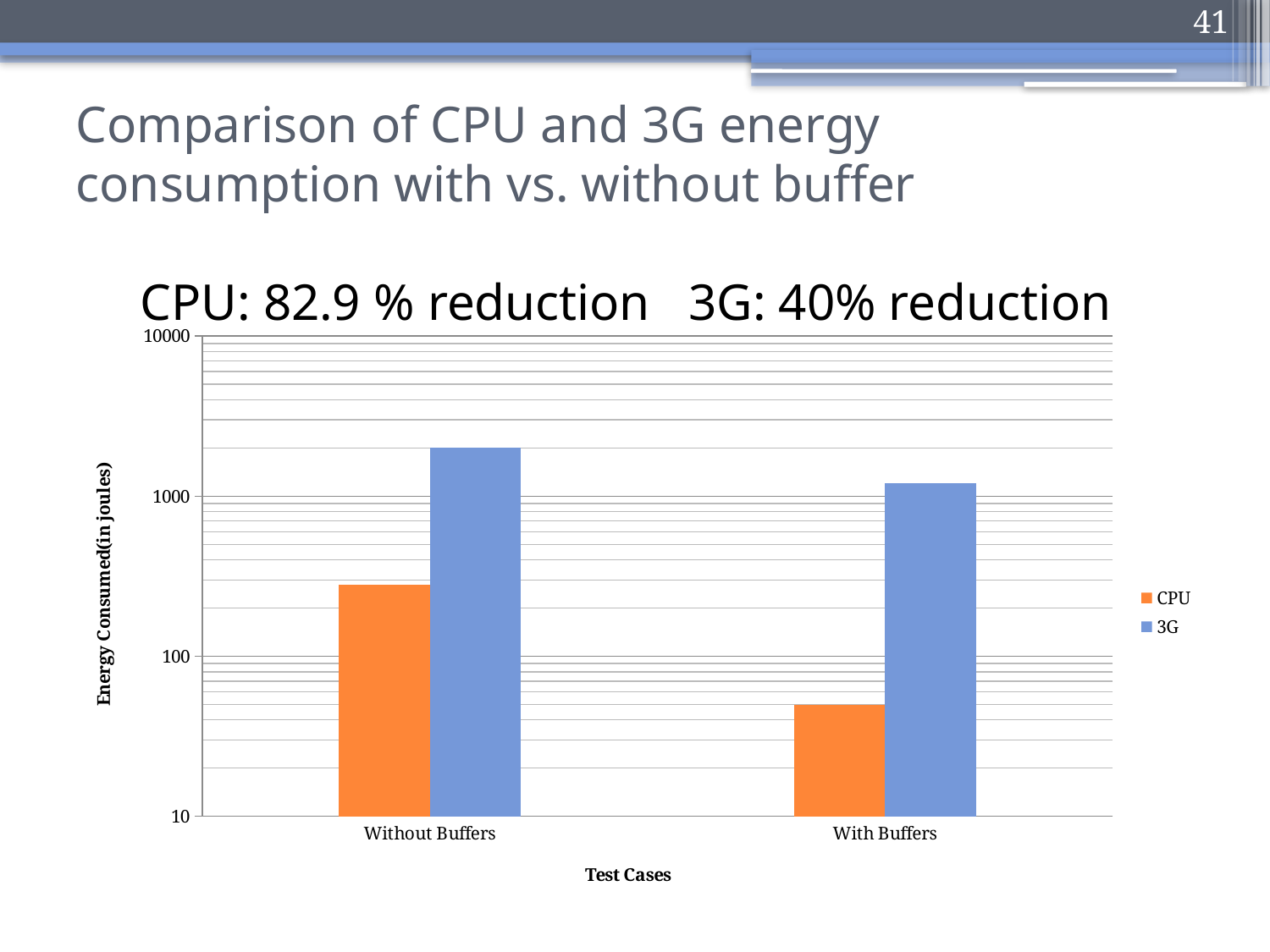
Does the CPU energy consumption rise or fall from Without Buffers to With Buffers? fall How many test case categories are shown on the x axis? 2 How many series does the legend list? 2 What kind of chart is shown on the slide? bar chart Is the CPU value for Without Buffers greater or less than 100? greater What is the label of the vertical axis? Energy Consumed(in joules) Which bar is the lowest in the chart? CPU for With Buffers Which series has the highest bar in the chart? 3G Is the CPU value for With Buffers greater or less than 100? less For With Buffers, which is larger, CPU or 3G energy consumption? 3G For Without Buffers, which is larger, CPU or 3G energy consumption? 3G Is the 3G value for Without Buffers greater or less than 1000? greater